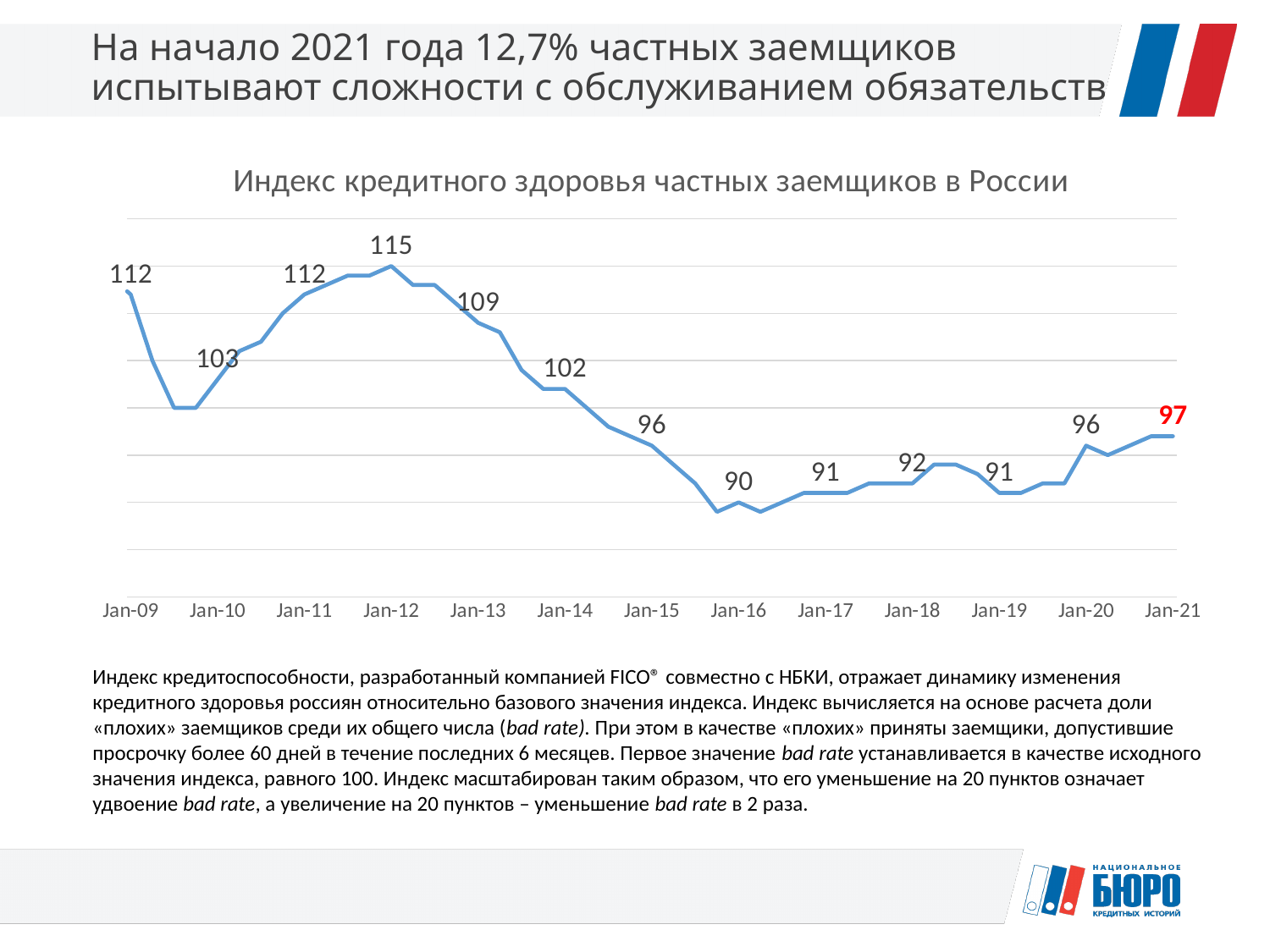
At which labelled date does the index reach its highest value? Jan-12 How many dates are labelled on the x axis? 13 What is the value of the index at Jan-12? 115 What is the title of the chart? Индекс кредитного здоровья частных заемщиков в России Which is larger, the index value at Jan-13 or at Jan-14? Jan-13 What is the value of the index at Jan-21? 97 What kind of chart is shown on the slide? Line chart What is the value of the index at Jan-09? 112 At which labelled date does the index reach its lowest value? Jan-16 What is the difference between the index values at Jan-12 and Jan-16? 25 What is the value of the index at Jan-16? 90 What is the difference between the index values at Jan-21 and Jan-20? 1